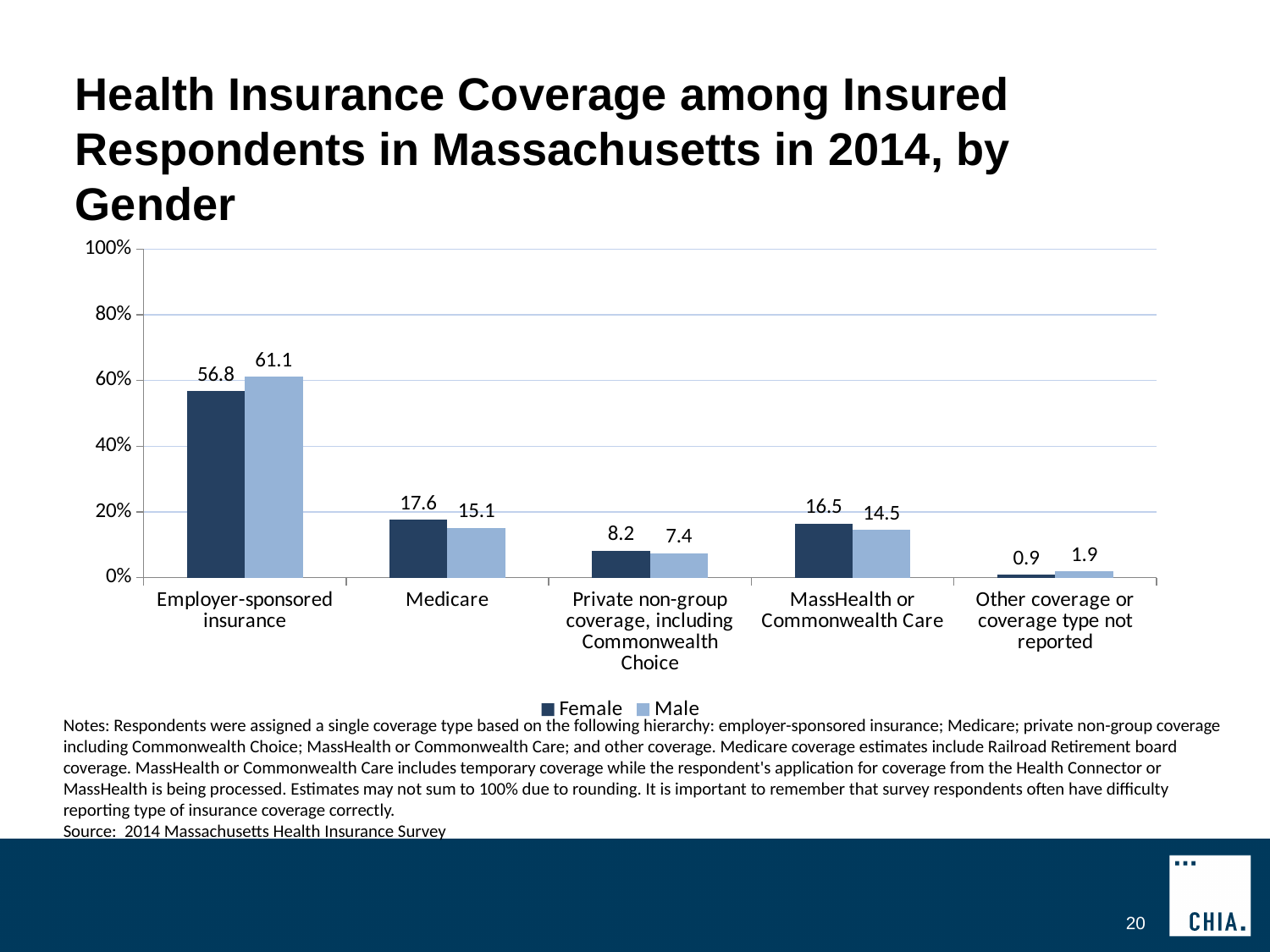
What is the Male value for Other coverage or coverage type not reported? 1.9 Which category has the highest Male value? Employer-sponsored insurance Which category has the lowest Female value? Other coverage or coverage type not reported How many coverage categories are shown on the x axis? 5 What is the source cited for the chart data? 2014 Massachusetts Health Insurance Survey Is the Female value for Employer-sponsored insurance greater or less than 40%? greater How many series does the legend list? 2 What kind of chart is shown on the slide? Bar chart What is the Female value for Employer-sponsored insurance? 56.8 What is the Male value for Medicare? 15.1 For MassHealth or Commonwealth Care, which is larger, the Female or the Male value? Female What is the difference between the Male and Female values for Employer-sponsored insurance? 4.3